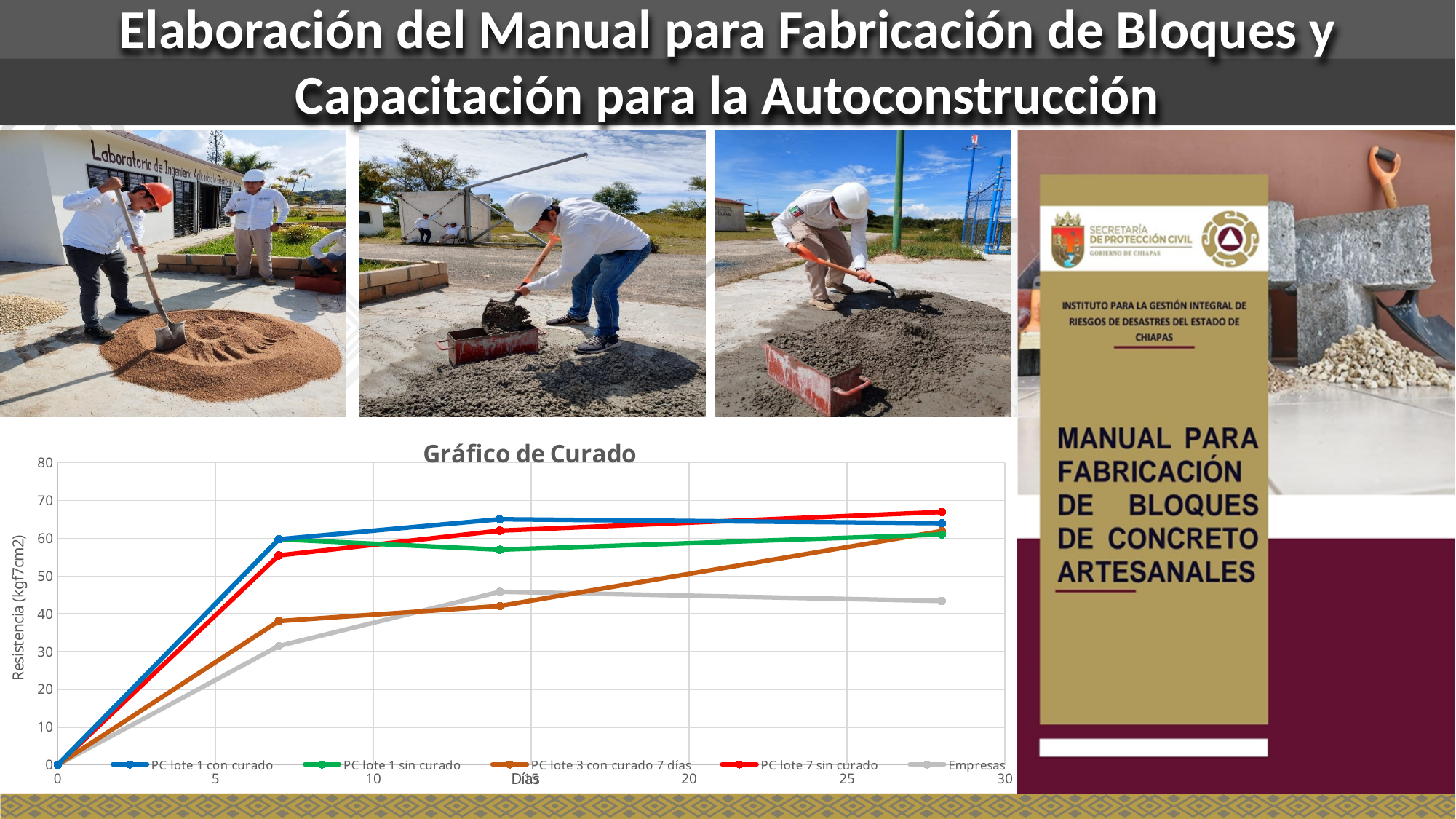
What is the title of the chart on the slide? Gráfico de Curado Is the value for PC lote 1 con curado at around day 7 greater or less than 50? greater Is the value for PC lote 3 con curado 7 días at around day 7 greater or less than 50? less How many data points are plotted for each series in the chart? 4 Is the value for Empresas at the last plotted point (around day 28) greater or less than 50? less Which series has the lowest value at the last plotted point (around day 28)? Empresas What is the label of the vertical axis of the chart? Resistencia (kgf7cm2) What kind of chart is "Gráfico de Curado"? line chart At around day 28, which is larger: PC lote 7 sin curado or Empresas? PC lote 7 sin curado How many series does the legend of "Gráfico de Curado" list? 5 Does the PC lote 3 con curado 7 días series rise or fall from day 0 to day 28? rise Which series has the lowest value at around day 7? Empresas